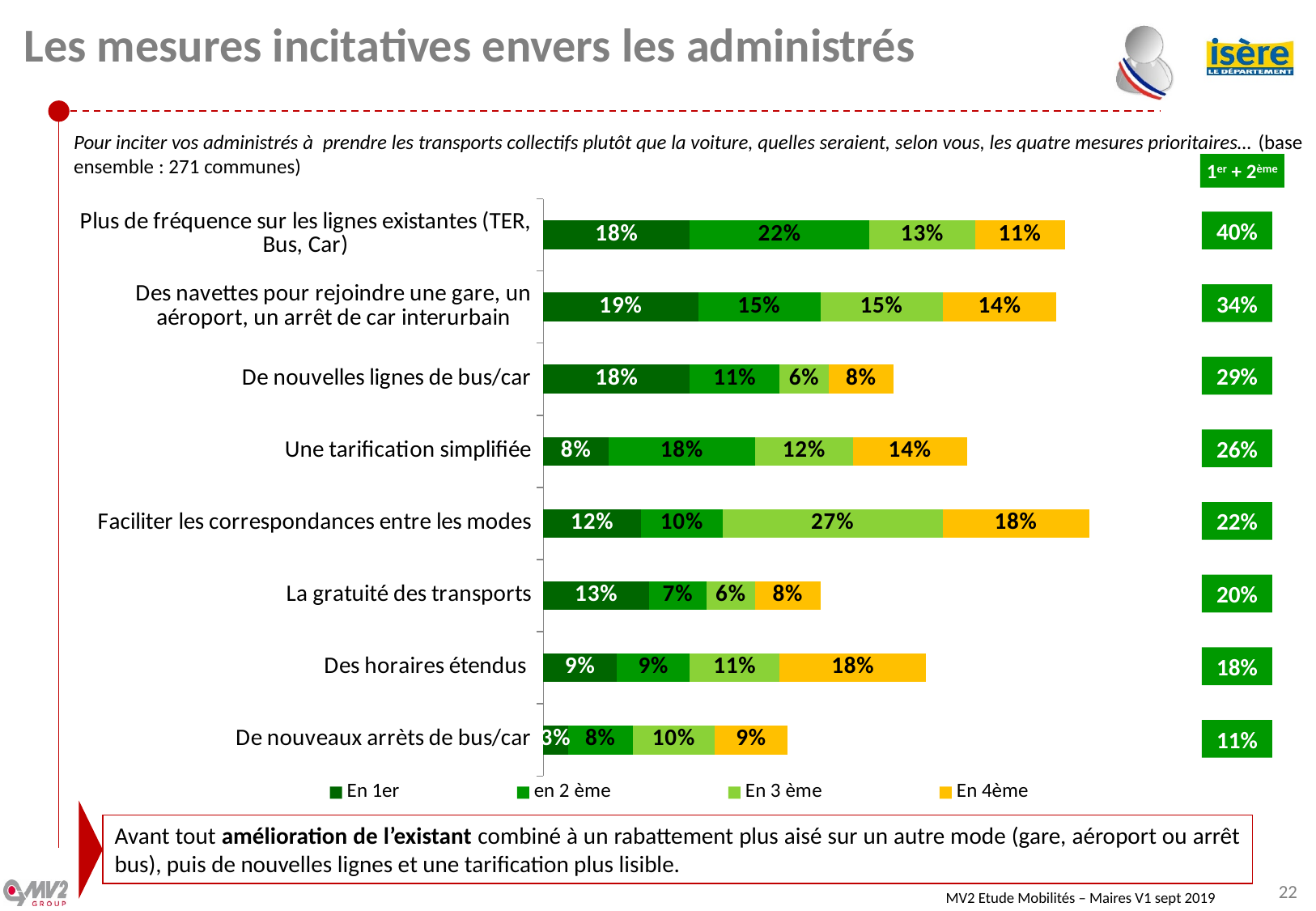
What is the difference between the 'en 2 ème' value for 'Plus de fréquence sur les lignes existantes (TER, Bus, Car)' and the 'en 2 ème' value for 'La gratuité des transports'? 15% What is the total of the stacked bar for 'La gratuité des transports'? 34% Which category has the highest 'En 1er' value? Des navettes pour rejoindre une gare, un aéroport, un arrêt de car interurbain What is the 'En 3 ème' value for 'Faciliter les correspondances entre les modes'? 27% What is the '1er + 2ème' value shown for 'De nouvelles lignes de bus/car'? 29% How many categories are shown in the chart? 8 Which is larger: the 'En 4ème' value for 'Une tarification simplifiée' or the 'En 4ème' value for 'De nouvelles lignes de bus/car'? Une tarification simplifiée What kind of chart is shown on the slide? Stacked bar chart How many series does the legend list? 4 What is the 'En 4ème' value for 'Des horaires étendus'? 18% What is the 'En 1er' value for 'Des navettes pour rejoindre une gare, un aéroport, un arrêt de car interurbain'? 19% Which category has the lowest 'En 1er' value? De nouveaux arrêts de bus/car